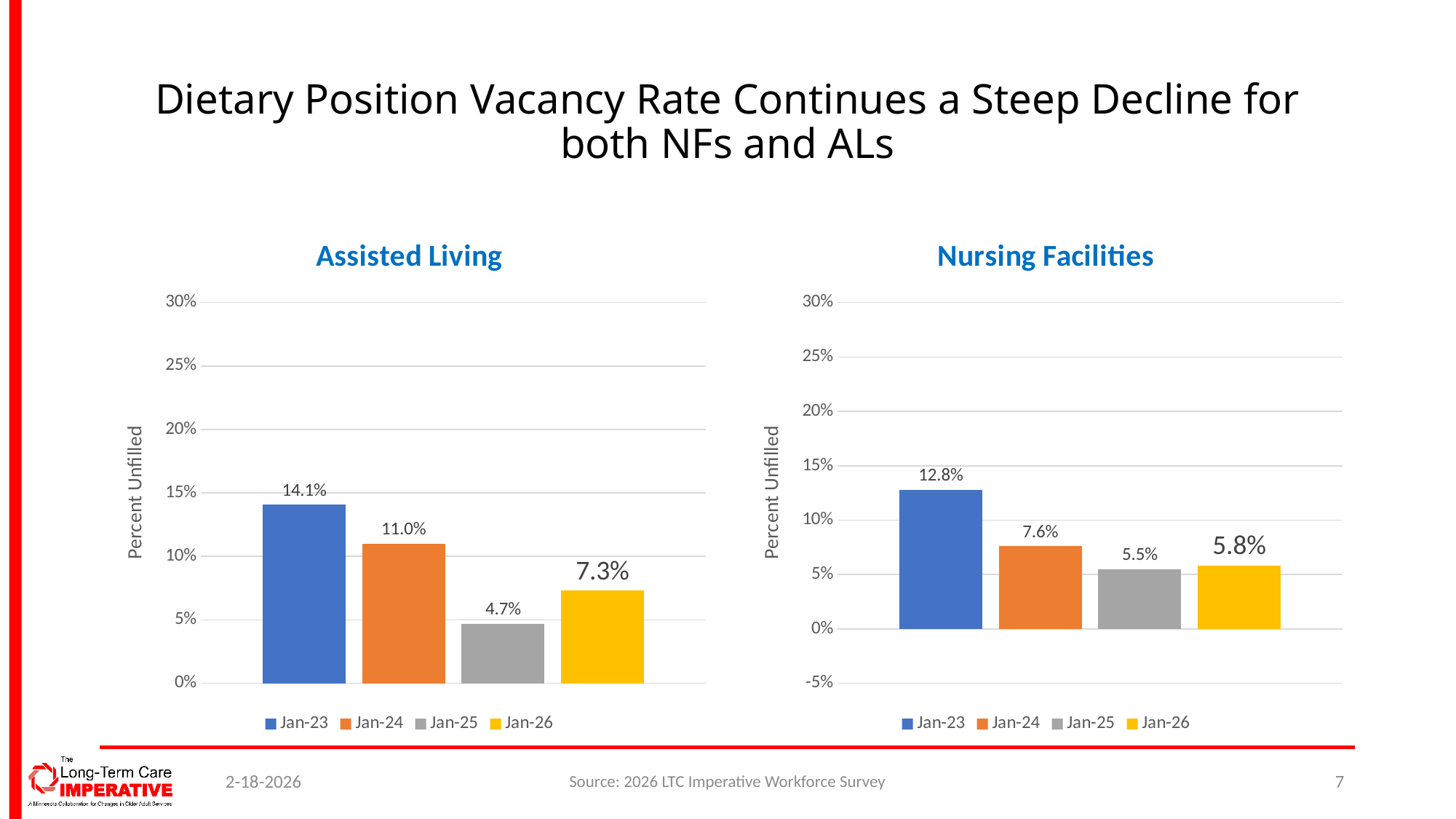
In the Nursing Facilities chart, what is the difference between the Jan-23 and Jan-25 values? 7.3% In the Assisted Living chart, what is the value for Jan-25? 4.7% In the Assisted Living chart, what is the difference between the Jan-23 and Jan-24 values? 3.1% What is the y-axis label on the Nursing Facilities chart? Percent Unfilled How many series does the legend of the Nursing Facilities chart list? 4 What kind of chart is the Assisted Living chart? bar chart In the Assisted Living chart, is the value for Jan-26 greater or less than 10%? less In the Assisted Living chart, which series has the lowest value? Jan-25 In the Nursing Facilities chart, which series has the highest value? Jan-23 In the Nursing Facilities chart, which is larger, the Jan-24 value or the Jan-26 value? Jan-24 In the Nursing Facilities chart, what is the value for Jan-26? 5.8% In the Assisted Living chart, what is the value for Jan-23? 14.1%